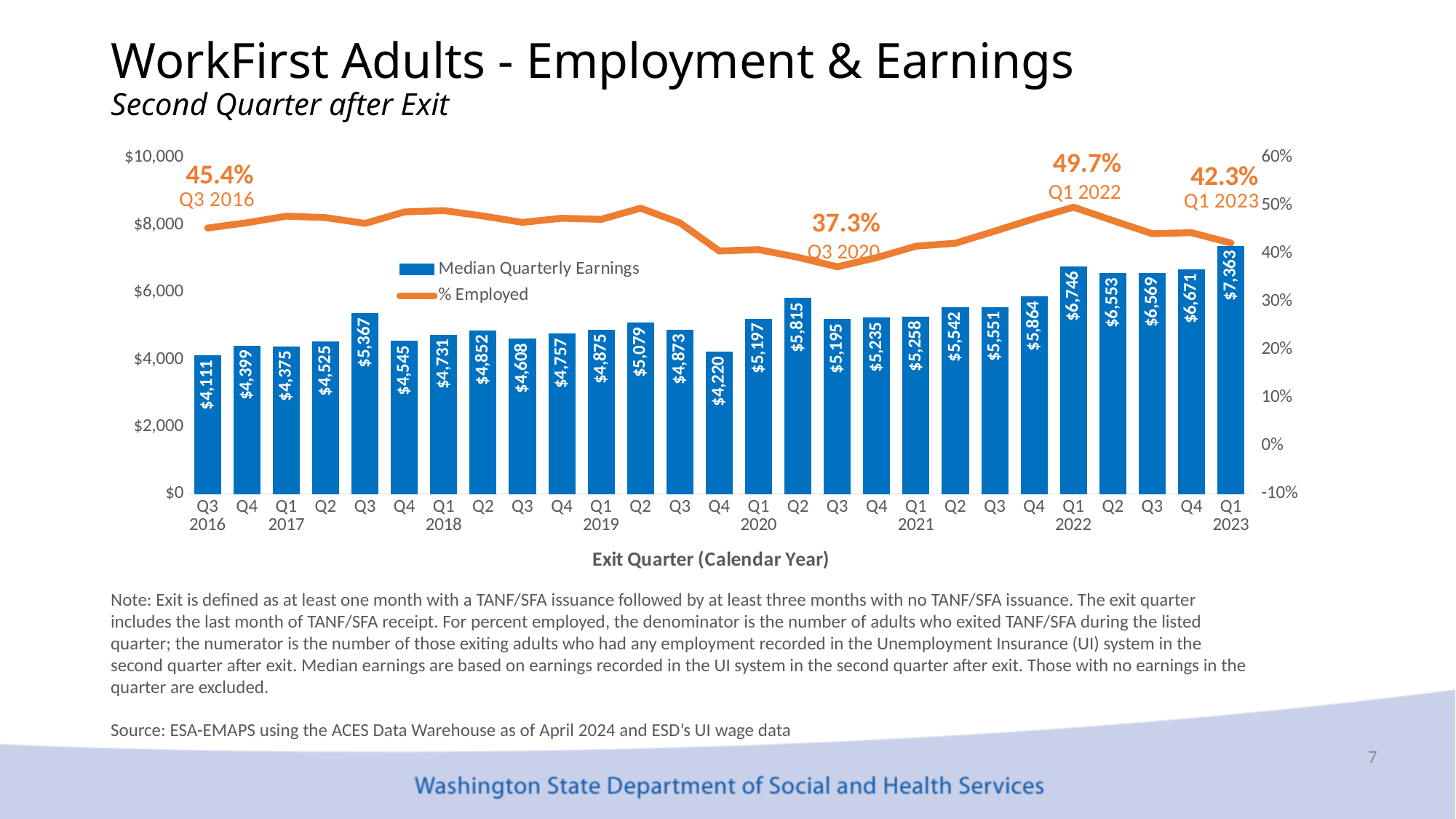
What kind of chart is shown on the slide? Combined bar and line chart Which exit quarter has the lowest median quarterly earnings? Q3 2016 What is the median quarterly earnings value for Q1 2023? $7,363 By how many percentage points did % Employed fall from Q1 2022 to Q1 2023? 7.4 percentage points Which has higher median quarterly earnings, Q3 2017 or Q4 2017? Q3 2017 Which exit quarter has the highest median quarterly earnings? Q1 2023 How many exit quarters are shown as bars on the chart? 27 What is the % Employed value labeled for Q3 2020? 37.3% Is the % Employed value for Q2 2019 greater or less than 40%? greater What is the difference in median quarterly earnings between Q1 2023 and Q3 2016? $3,252 How many series does the legend list? 2 What is the % Employed value labeled for Q1 2022? 49.7%